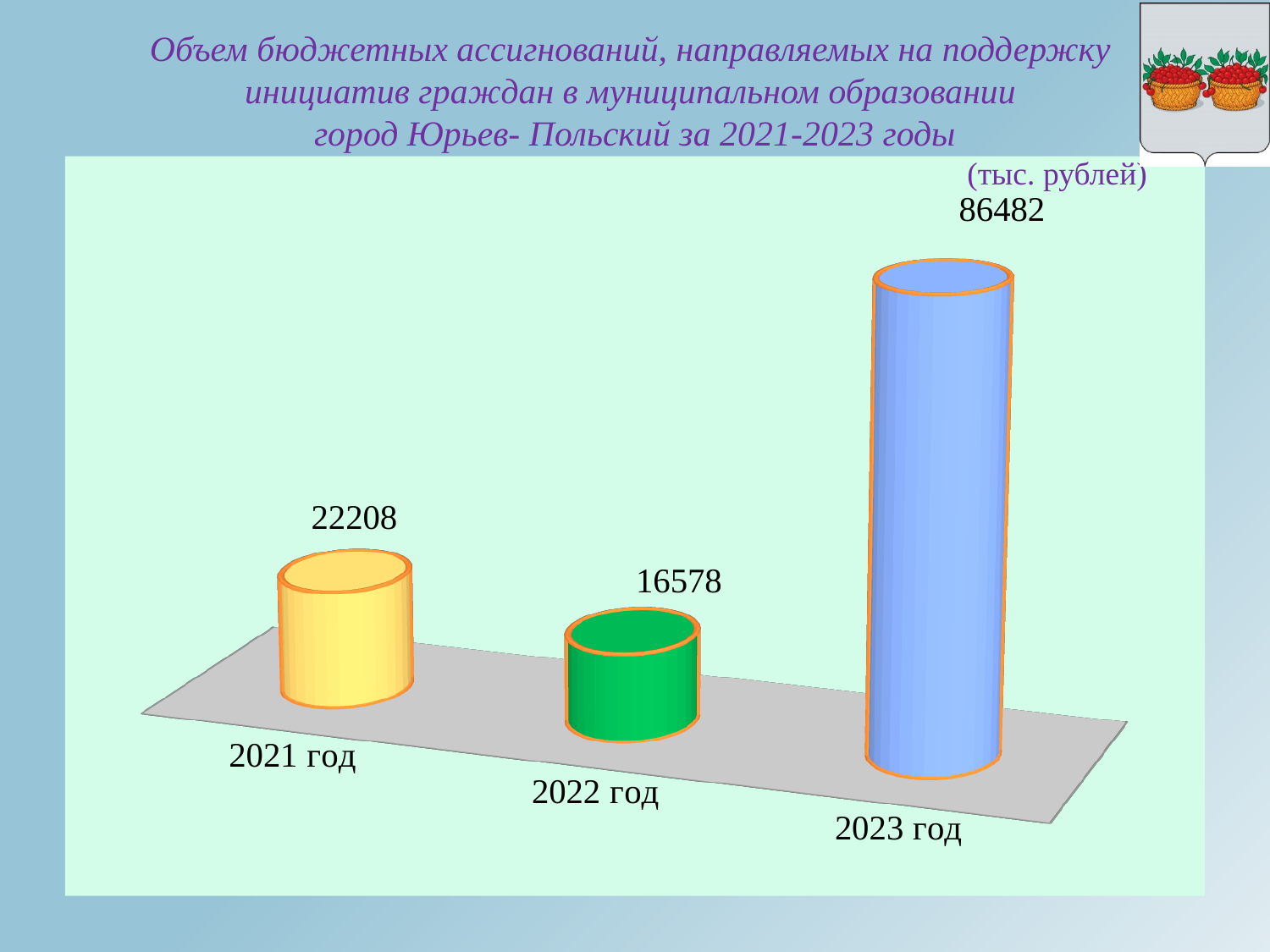
Which year has the highest value? 2023 год In what units are the values on the chart given? тыс. рублей What is the difference between the values for 2023 год and 2021 год? 64274 What is the value for 2022 год? 16578 Which year has the lowest value? 2022 год What is the difference between the values for 2021 год and 2022 год? 5630 What is the value for 2023 год? 86482 Does the value rise or fall from 2022 год to 2023 год? rise What is the value for 2021 год? 22208 How many years are shown in the chart? 3 Which is larger, the value for 2021 год or the value for 2022 год? 2021 год What kind of chart is shown on the slide? bar chart